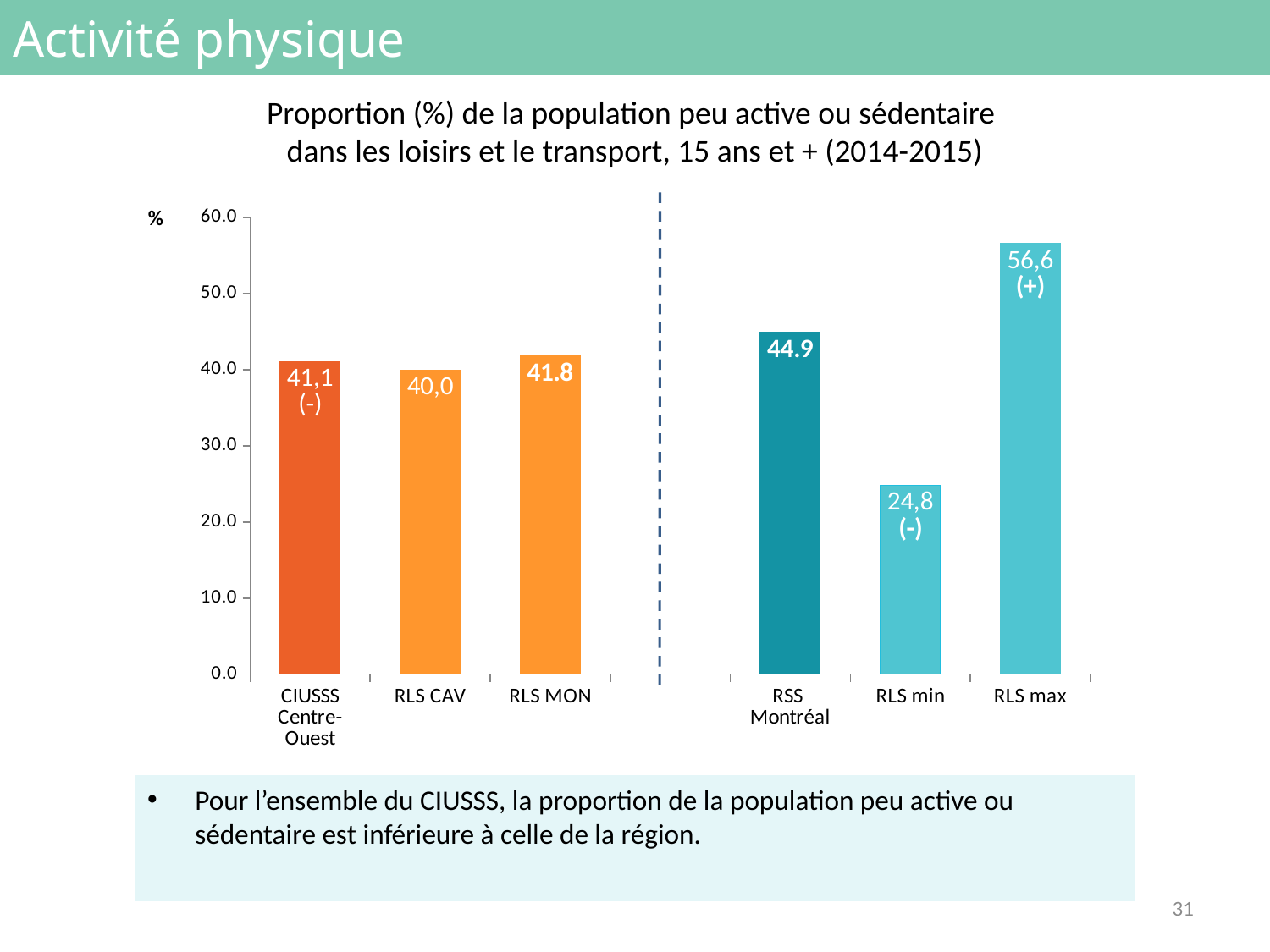
What is the value for RLS max? 56,6 Which is larger, the value for RLS CAV or the value for RLS MON? RLS MON Which category has the lowest value? RLS min What is the value for CIUSSS Centre-Ouest? 41,1 How many bars are plotted in the chart? 6 Is the value for RLS min greater or less than 30.0? less What is the value for RSS Montréal? 44.9 What is the difference between the values for RLS max and RLS min? 31,8 Which category has the highest value? RLS max What type of chart is shown on the slide? bar chart What is the value for RLS CAV? 40,0 What is the difference between the values for RSS Montréal and RLS MON? 3.1